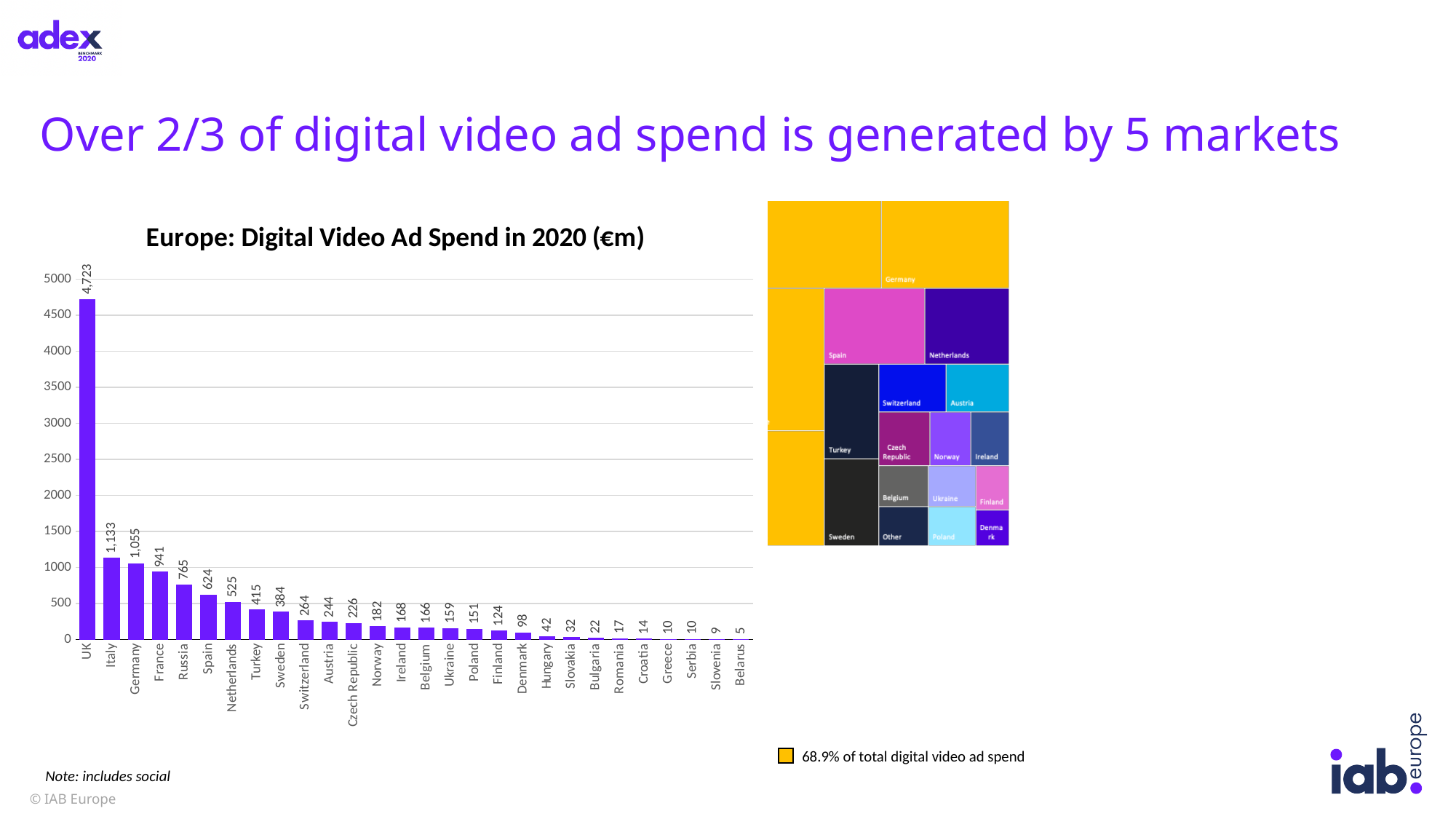
In the bar chart 'Europe: Digital Video Ad Spend in 2020 (€m)', is the value for Russia greater or less than 500? greater In the bar chart 'Europe: Digital Video Ad Spend in 2020 (€m)', what is the value for Germany? 1,055 How many countries are shown in the bar chart 'Europe: Digital Video Ad Spend in 2020 (€m)'? 28 In the bar chart 'Europe: Digital Video Ad Spend in 2020 (€m)', which is larger, the value for Spain or the value for Netherlands? Spain In the bar chart 'Europe: Digital Video Ad Spend in 2020 (€m)', what is the value for the UK? 4,723 In the bar chart 'Europe: Digital Video Ad Spend in 2020 (€m)', what is the difference between the values for Italy and France? 192 In the bar chart 'Europe: Digital Video Ad Spend in 2020 (€m)', do the values rise or fall from left to right along the x axis? fall What kind of chart is 'Europe: Digital Video Ad Spend in 2020 (€m)'? bar chart According to the legend below the treemap on the right, what share of total digital video ad spend do the yellow boxes represent? 68.9% In the bar chart 'Europe: Digital Video Ad Spend in 2020 (€m)', what is the value for Czech Republic? 226 In the bar chart 'Europe: Digital Video Ad Spend in 2020 (€m)', which country has the lowest value? Belarus In the bar chart 'Europe: Digital Video Ad Spend in 2020 (€m)', which country has the highest value? UK